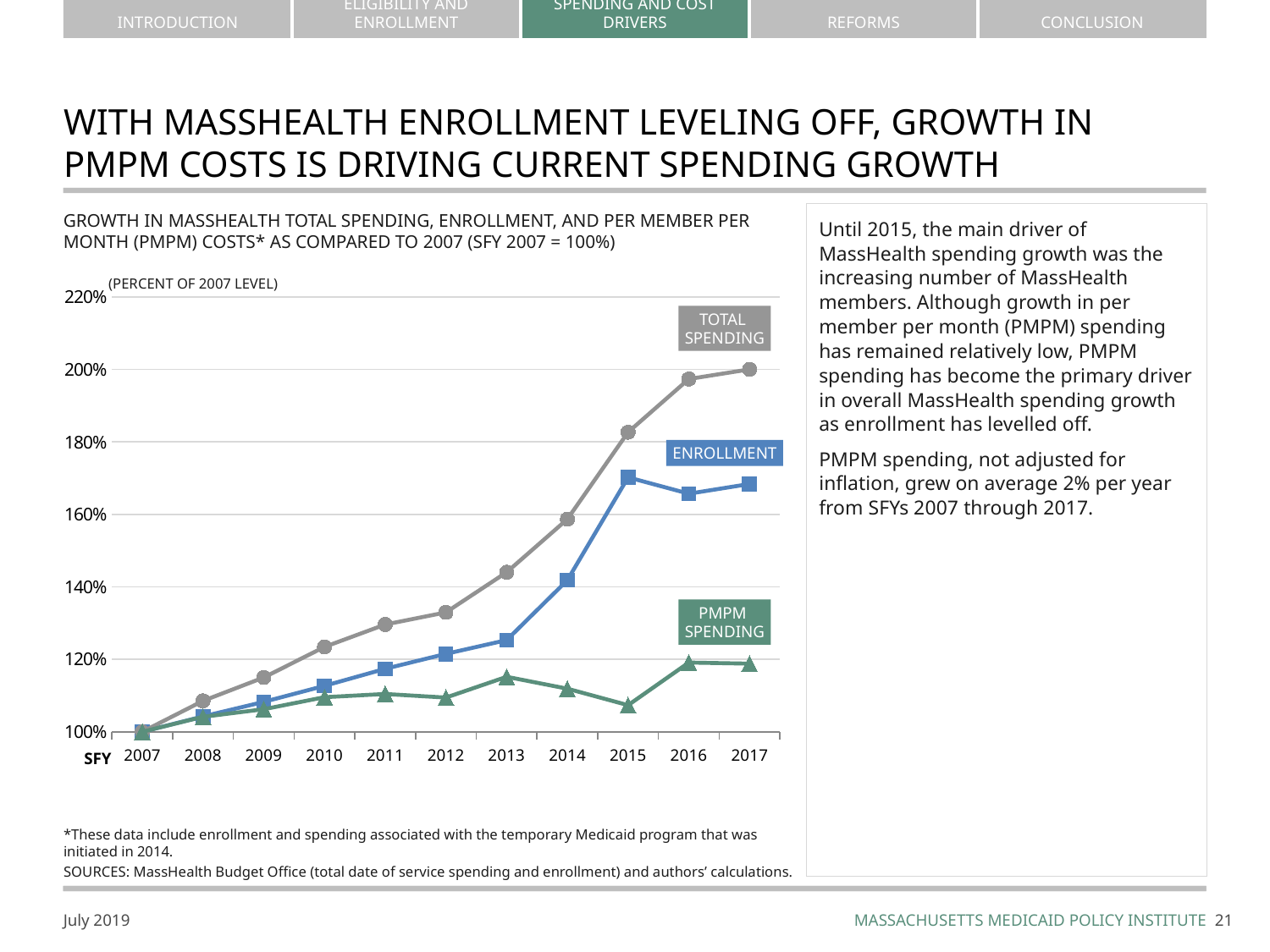
Does Total Spending rise or fall from 2007 to 2017? rise How many series are plotted on the chart? 3 How many fiscal years are shown along the x axis of the chart? 11 Which series has the highest value in 2017? Total Spending Is the value for PMPM Spending in 2017 greater or less than 140%? less What kind of chart is shown on the slide? line chart Is the value for Total Spending in 2012 greater or less than 140%? less What is the value of Total Spending in SFY 2007? 100% Which series has the lowest value in 2017? PMPM Spending Is the value for Total Spending in 2017 greater or less than 180%? greater In 2014, which is larger: Enrollment or PMPM Spending? Enrollment